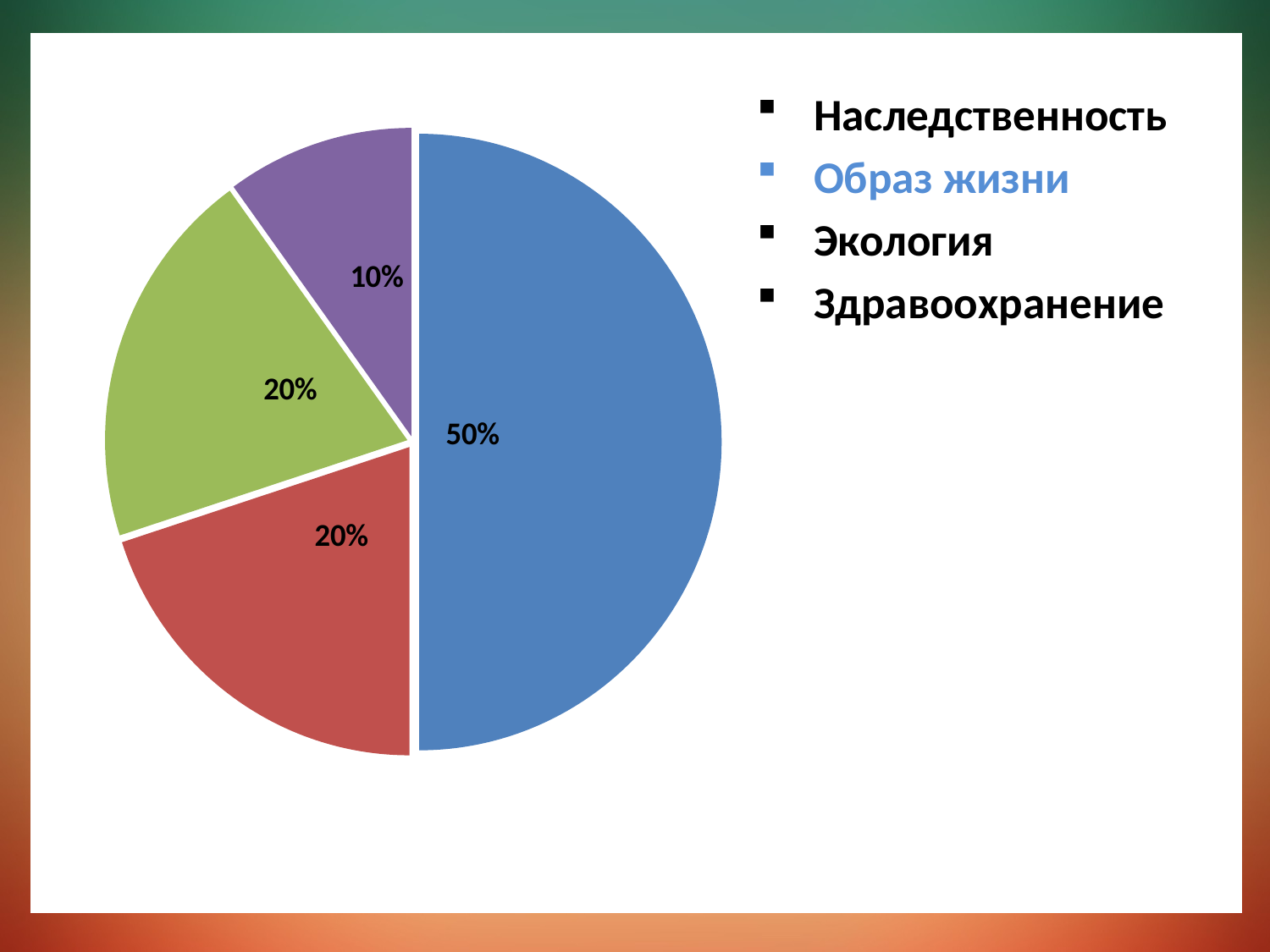
What is the difference between the largest slice and the smallest slice of the pie chart? 40% What kind of chart is shown on the slide? pie chart What is the value of the smallest slice of the pie chart? 10% What percentage is shown on the purple slice of the pie chart? 10% Which slice is larger, the blue one or the purple one? the blue one What is the value of the largest slice of the pie chart? 50% What percentage is shown on the red slice of the pie chart? 20% What percentage is shown on the blue slice of the pie chart? 50% Which item in the bulleted list next to the pie chart is written in blue text? Образ жизни How many slices does the pie chart have? 4 What percentage is shown on the green slice of the pie chart? 20% How many items are listed in the bulleted list to the right of the pie chart? 4